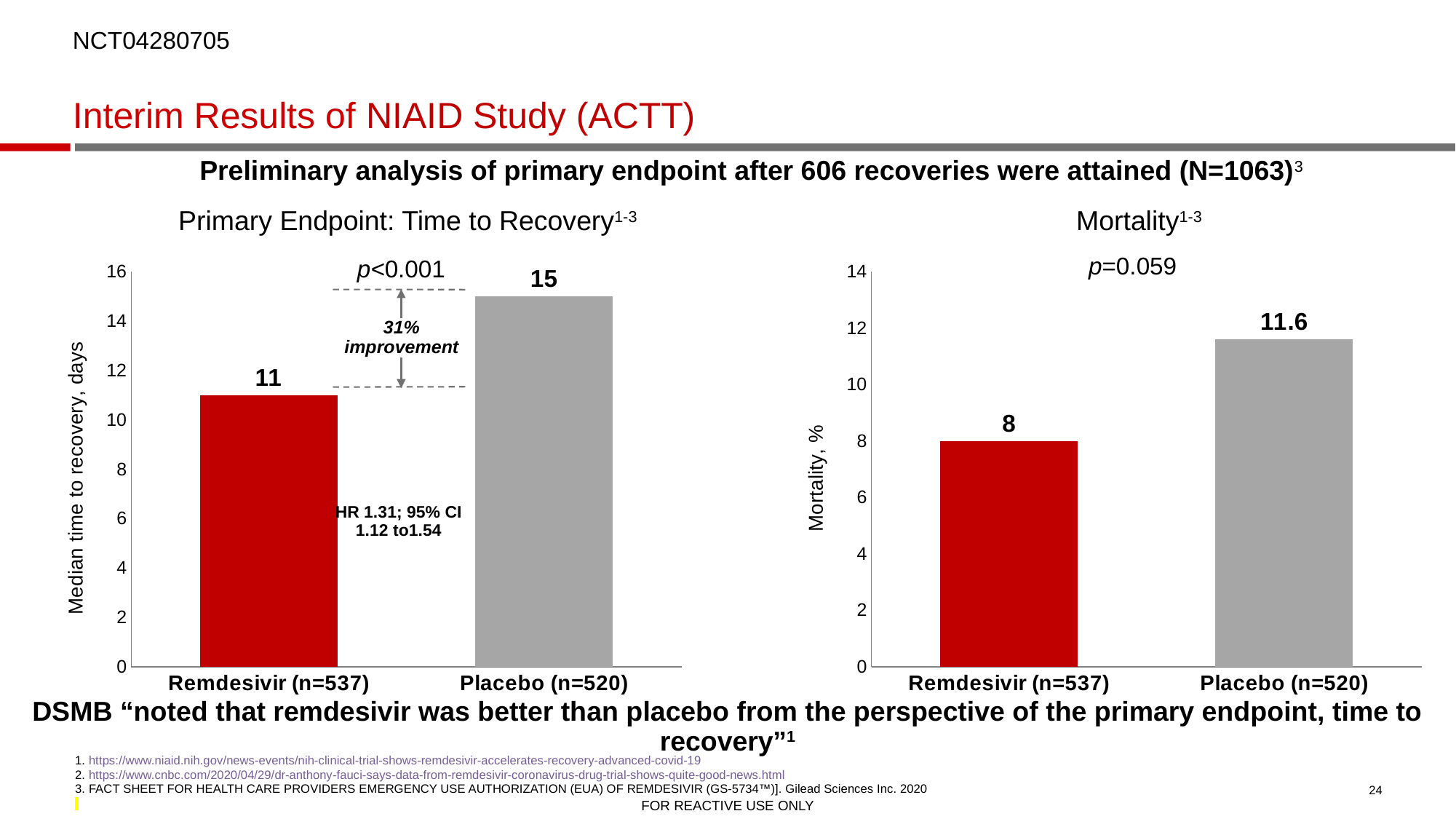
In the Mortality chart, what is the mortality percentage for Placebo (n=520)? 11.6 What p-value is shown on the Mortality chart? p=0.059 In the Primary Endpoint: Time to Recovery chart, which group has the longer median time to recovery? Placebo (n=520) What type of chart is the Primary Endpoint: Time to Recovery chart? Bar chart In the Mortality chart, what is the mortality percentage for Remdesivir (n=537)? 8 In the Mortality chart, which group has the lower mortality? Remdesivir (n=537) In the Primary Endpoint: Time to Recovery chart, what is the difference in median time to recovery between Placebo and Remdesivir? 4 In the Mortality chart, what is the difference in mortality between Placebo and Remdesivir? 3.6 How many bars are shown in the Mortality chart? 2 In the Primary Endpoint: Time to Recovery chart, what is the median time to recovery for Remdesivir (n=537)? 11 In the Primary Endpoint: Time to Recovery chart, what is the median time to recovery for Placebo (n=520)? 15 In the Mortality chart, is the value for Remdesivir (n=537) greater or less than 10? less